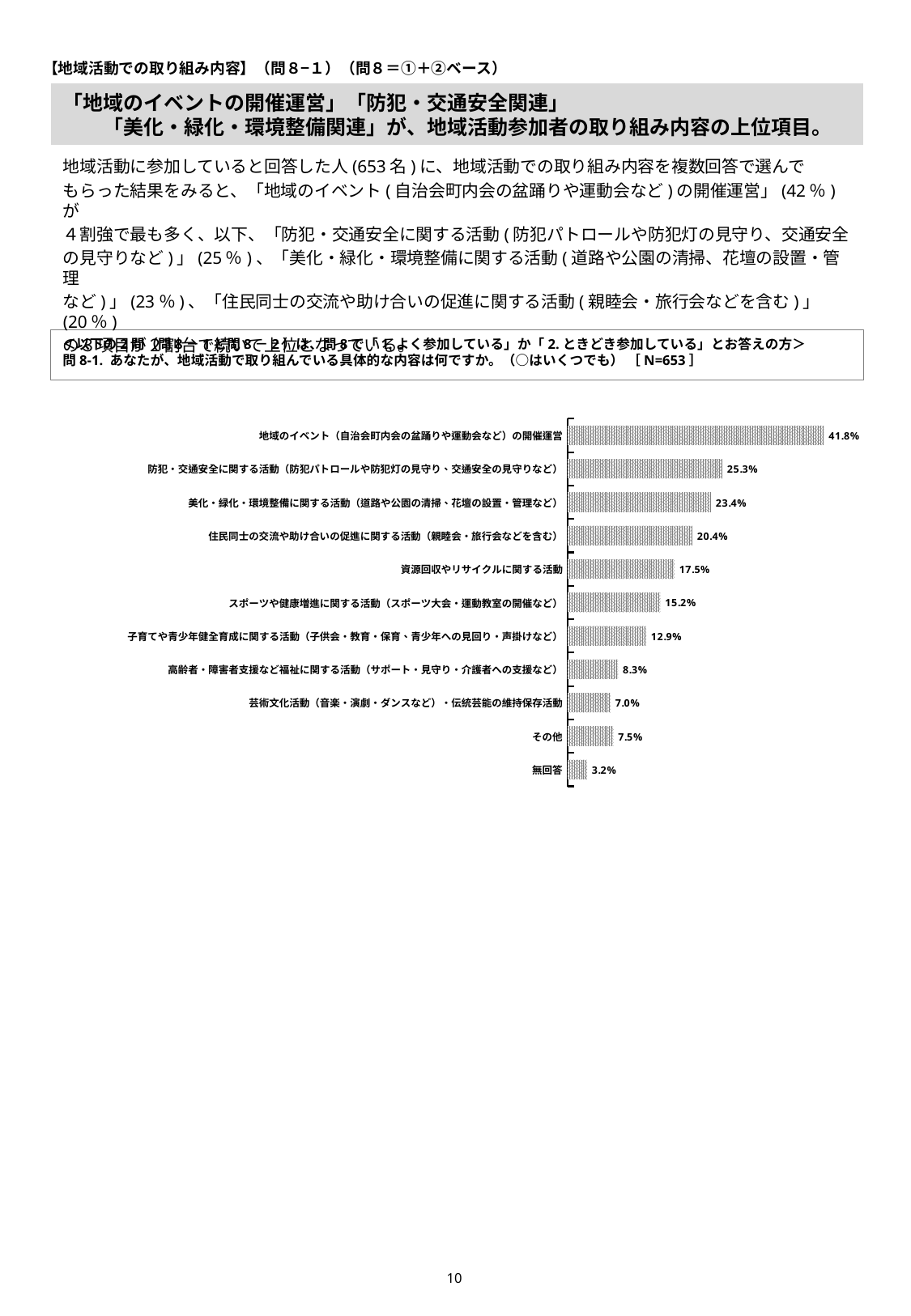
How many categories are shown in the chart? 11 Which category has the lowest value? 無回答 Which is larger: その他 or 芸術文化活動（音楽・演劇・ダンスなど）・伝統芸能の維持保存活動? その他 What is the value for 子育てや青少年健全育成に関する活動（子供会・教育・保育、青少年への見回り・声掛けなど）? 12.9% What is the value for 地域のイベント（自治会町内会の盆踊りや運動会など）の開催運営? 41.8% What is the value for 資源回収やリサイクルに関する活動? 17.5% Which category has the highest value? 地域のイベント（自治会町内会の盆踊りや運動会など）の開催運営 What is the sample size (N) stated in the question text above the chart? N=653 What kind of chart is shown on the slide? Bar chart What is the value for その他? 7.5% What is the value for 無回答? 3.2% What is the difference between 防犯・交通安全に関する活動 (25.3%) and 美化・緑化・環境整備に関する活動 (23.4%)? 1.9%